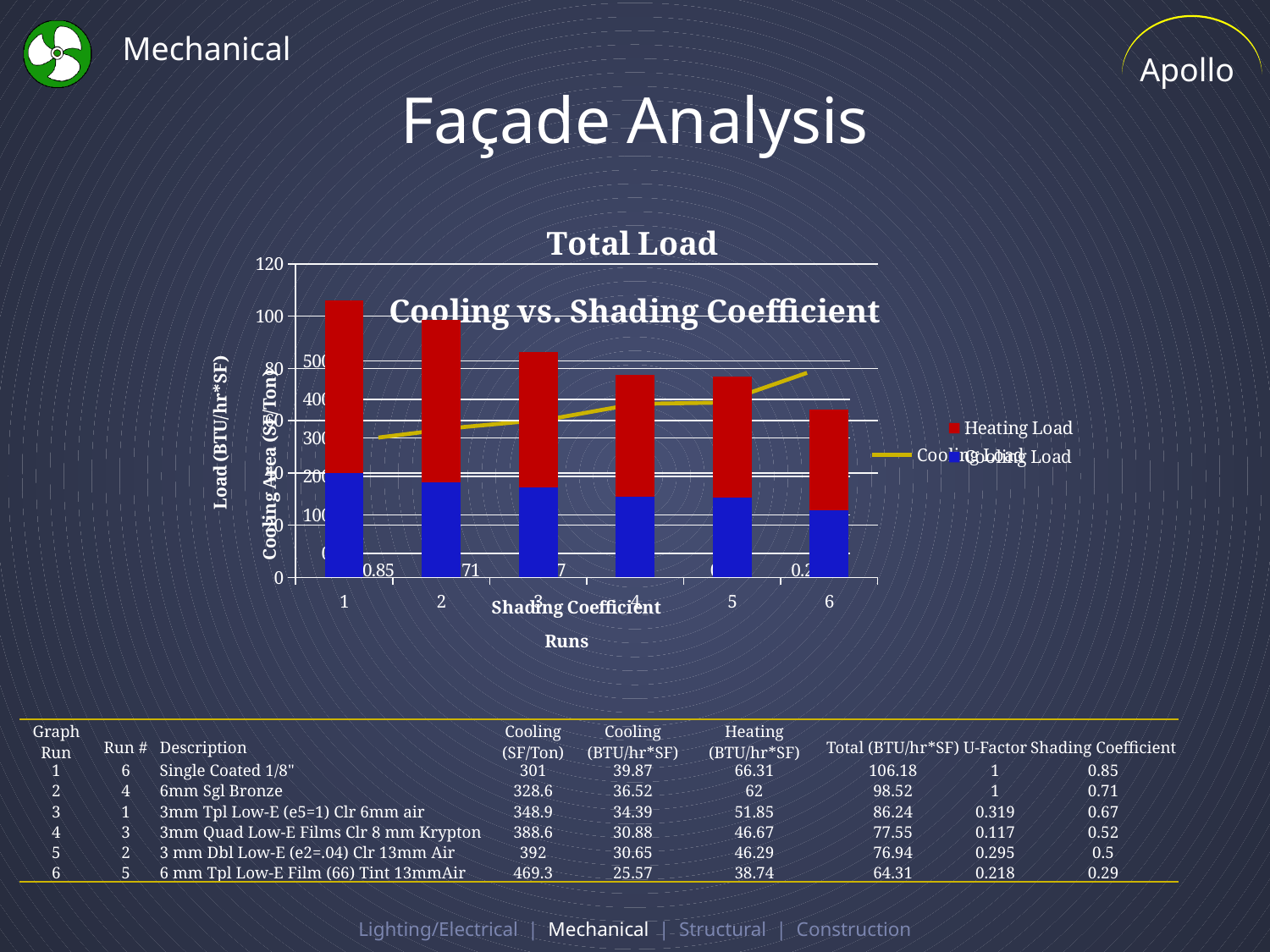
In the Total Load chart, which run has the lowest total load? 6 In the Total Load chart, is the total load for run 1 greater or less than 100? greater In the Total Load chart, what type of chart is used to show the Heating Load and Cooling Load? stacked bar chart In the Cooling vs. Shading Coefficient chart, does the Cooling line rise or fall along the x axis? rise In the Total Load chart, which is larger for run 1, the Heating Load or the Cooling Load? Heating Load In the Total Load chart, how many runs are shown on the x axis? 6 In the Total Load chart, is the total load for run 6 greater or less than 80? less In the Total Load chart, which run has the highest total load? 1 In the Total Load chart, do the total loads rise or fall from run 1 to run 6? fall What is the y-axis label of the Total Load chart? Load (BTU/hr*SF) In the Total Load chart, how many series does the legend list? 2 In the Total Load chart, is the Cooling Load for run 6 greater or less than 40? less